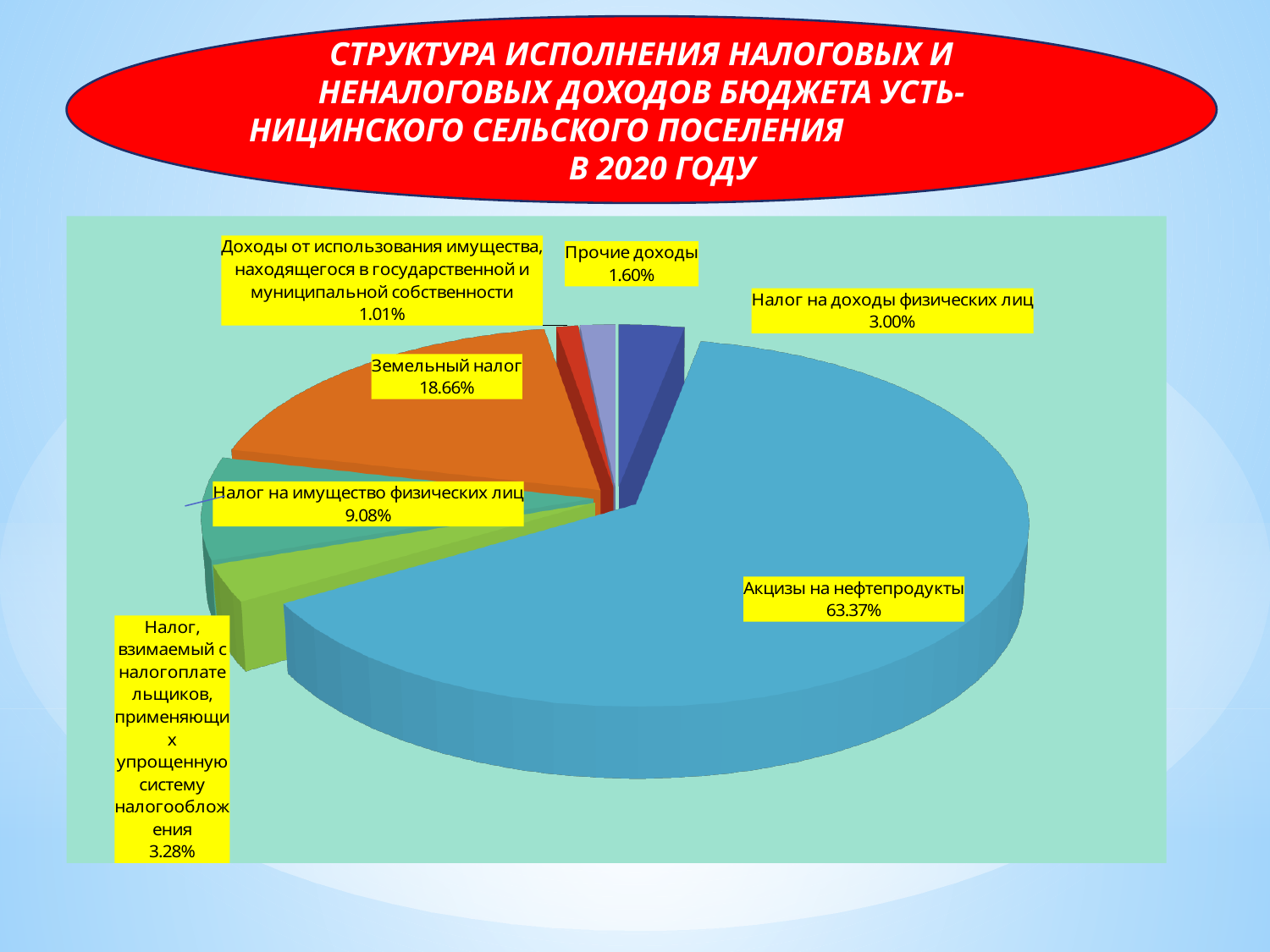
What percentage is shown for Налог на имущество физических лиц? 9.08% What is the value for Налог на доходы физических лиц? 3.00% Which is larger: the share for Налог на доходы физических лиц or the share for Прочие доходы? Налог на доходы физических лиц How many slices does the pie chart have? 7 What percentage is labelled for Прочие доходы? 1.60% What share of the pie does Акцизы на нефтепродукты have? 63.37% Which category has the smallest share of the pie? Доходы от использования имущества, находящегося в государственной и муниципальной собственности What is the value for Доходы от использования имущества, находящегося в государственной и муниципальной собственности? 1.01% What type of chart is shown on the slide? pie chart What is the value shown for Земельный налог? 18.66% What is the difference between the shares of Земельный налог and Налог на имущество физических лиц? 9.58% Which category has the largest share of the pie? Акцизы на нефтепродукты